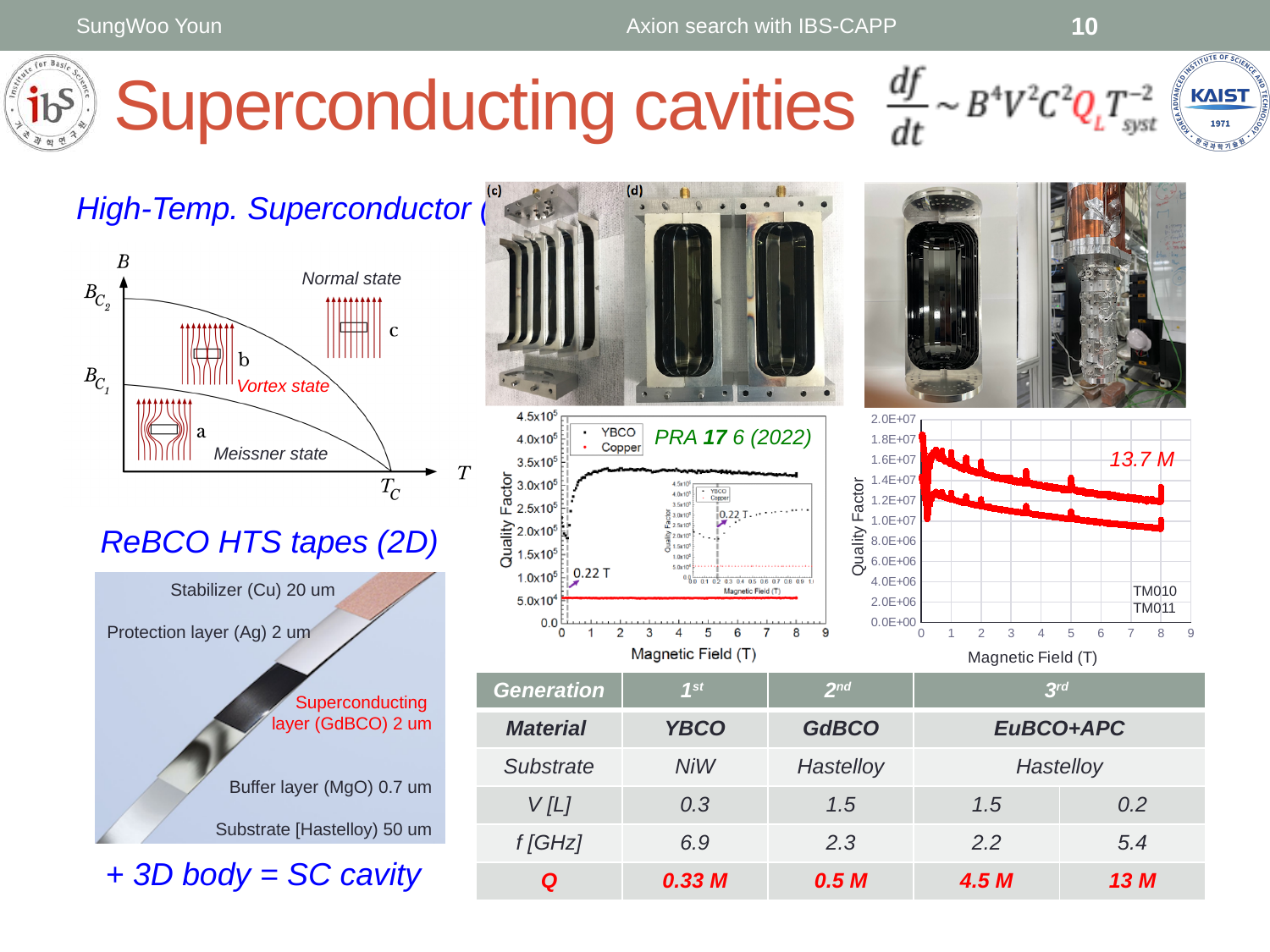
In the left chart (PRA 17 6 (2022)), which series has the higher quality factor, YBCO or Copper? YBCO What kind of chart is the left chart (PRA 17 6 (2022)) showing Quality Factor versus Magnetic Field? scatter plot In the left chart (PRA 17 6 (2022)), which two materials are listed in the legend? YBCO and Copper In the right chart (TM010/TM011), is the quality factor of the upper series at 8 T greater or less than 1.0E+07? greater In the left chart (PRA 17 6 (2022)), is the quality factor of YBCO at 4 T greater or less than 2.0x10^5? greater In the left chart (PRA 17 6 (2022)), is the quality factor of Copper at 4 T greater or less than 1.0x10^5? less In the left chart (PRA 17 6 (2022)), what is the highest tick value shown on the Magnetic Field axis? 9 In the right chart (Quality Factor vs Magnetic Field with TM010 and TM011), how many series does the legend list? 2 In the right chart (TM010/TM011), what quality factor value is annotated in red on the plot? 13.7 M In the right chart (TM010/TM011), does the quality factor rise or fall as the magnetic field increases? fall In the left chart (Quality Factor vs Magnetic Field, PRA 17 6 (2022)), how many series does the legend list? 2